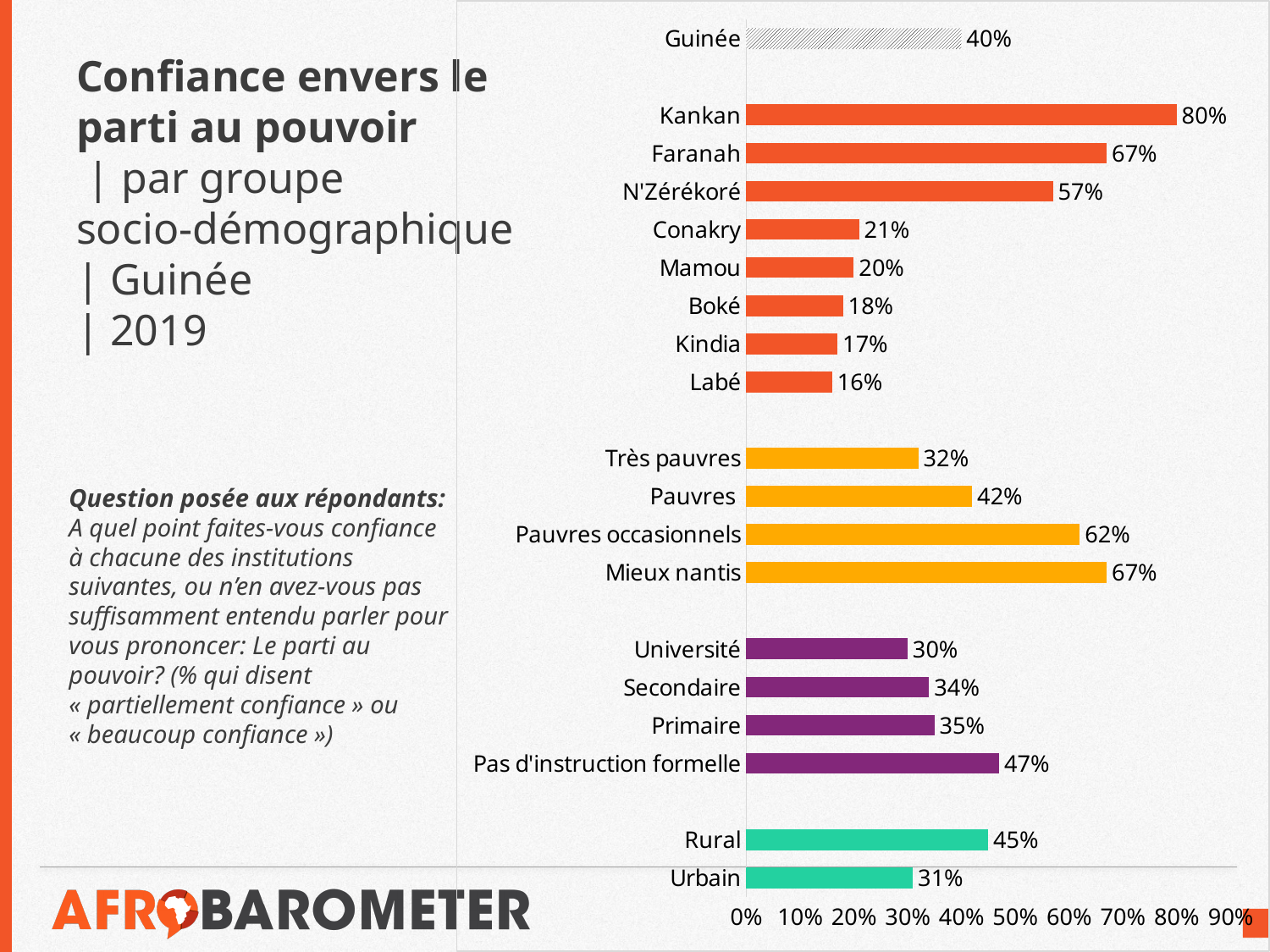
What is the value for Université? 30% How many bars are plotted on the chart? 19 What is the value for Guinée overall? 40% Is the value for Mieux nantis greater or less than 60%? greater What is the difference between Kankan and Conakry? 59 percentage points Which region has the highest value? Kankan What is the value for Kankan? 80% Which region has the lowest value? Labé What kind of chart is shown? Bar chart What is the value for Pas d'instruction formelle? 47% What is the difference between Rural and Urbain? 14 percentage points Which is larger, Pauvres or Très pauvres? Pauvres